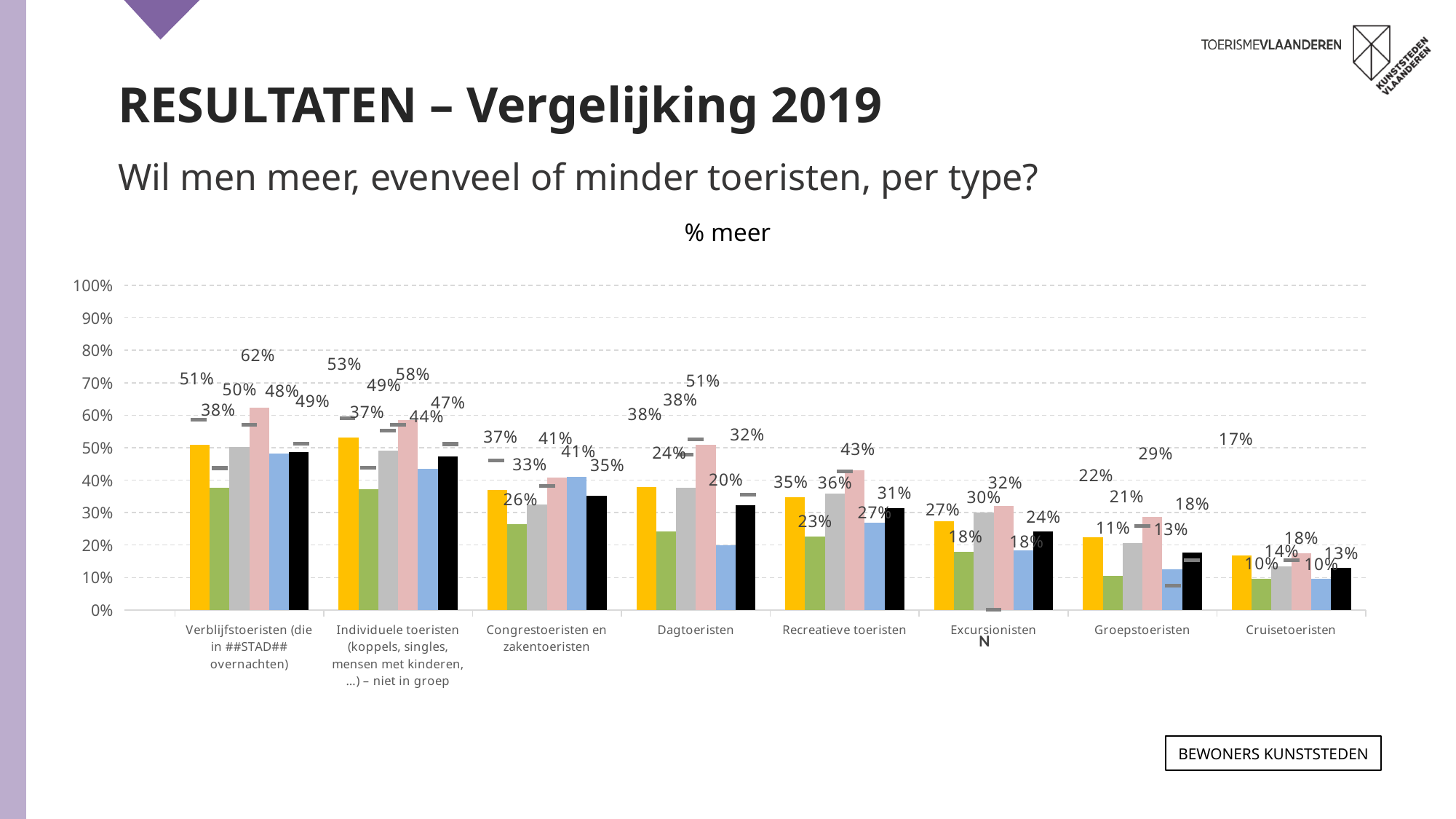
Which category has the lowest value for the pink bar? Cruisetoeristen How many tourist-type categories are shown on the x axis? 8 Do the values of the yellow bars generally rise or fall from left to right along the x axis? fall Which category has the highest value for the black bar? Verblijfstoeristen (die in ##STAD## overnachten) What is the value of the green bar for Cruisetoeristen? 10% What is the value of the yellow bar for Individuele toeristen? 53% What is the title of the chart? % meer What is the value of the pink bar for Verblijfstoeristen? 62% What is the value of the black bar for Dagtoeristen? 32% What is the difference between the pink bar and the green bar for Dagtoeristen? 27% What kind of chart is shown on the slide? bar chart For Groepstoeristen, which is larger: the yellow bar or the grey bar? the yellow bar